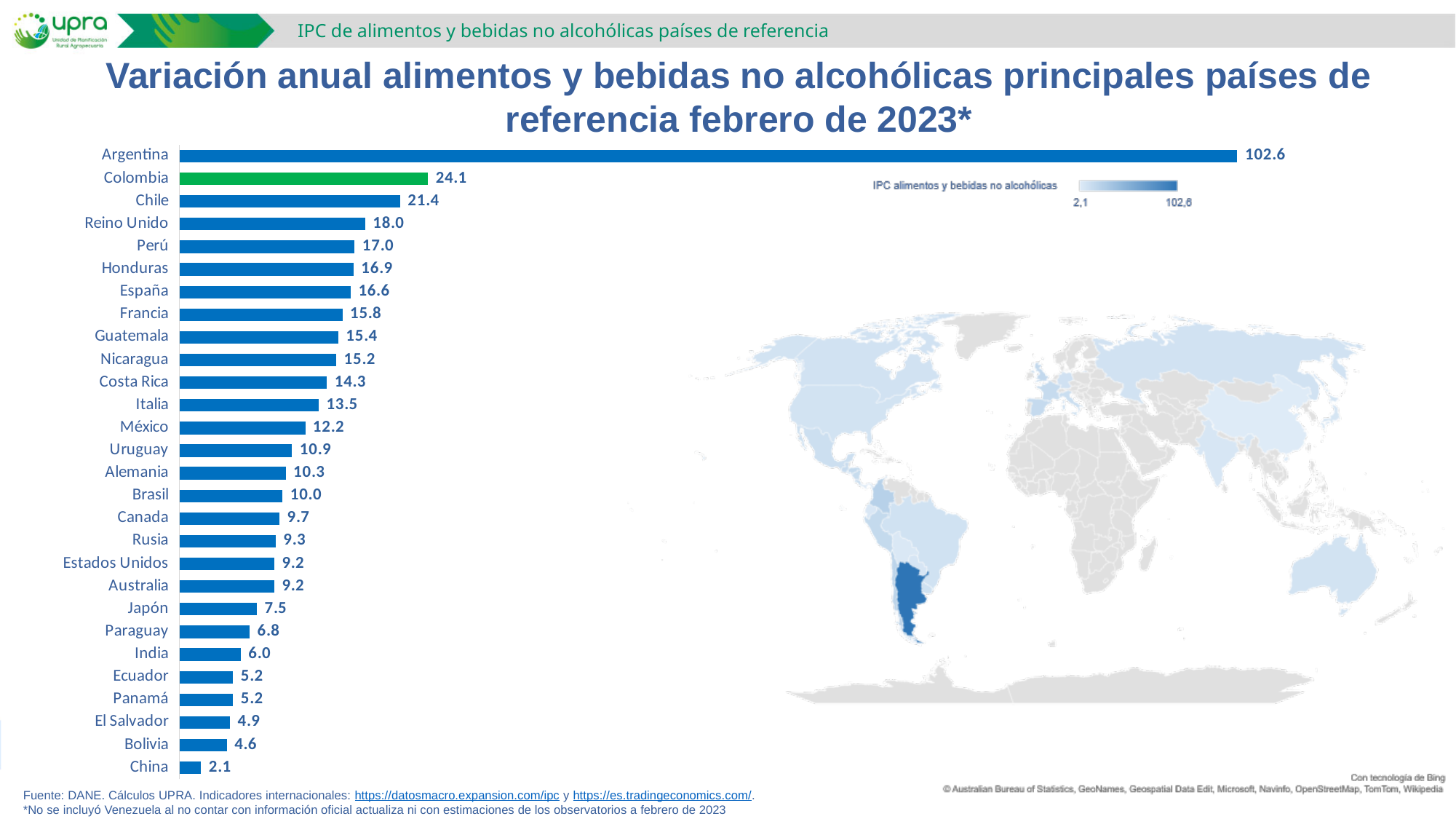
In the bar chart, which has a larger value, Brasil or Canada? Brasil How many countries are shown in the bar chart? 28 In the bar chart, what is the difference between the values for Chile and Perú? 4.4 In the bar chart, which country has the highest value? Argentina In the bar chart, what is the value for Reino Unido? 18.0 In the bar chart, what is the difference between the values for Argentina and Colombia? 78.5 In the bar chart, which has a larger value, México or Uruguay? México In the bar chart, which country has the lowest value? China In the bar chart, what is the value for Japón? 7.5 In the bar chart, what is the value for Colombia? 24.1 What kind of chart is used to show the annual variation by country? Bar chart In the bar chart, which country's bar is coloured green instead of blue? Colombia